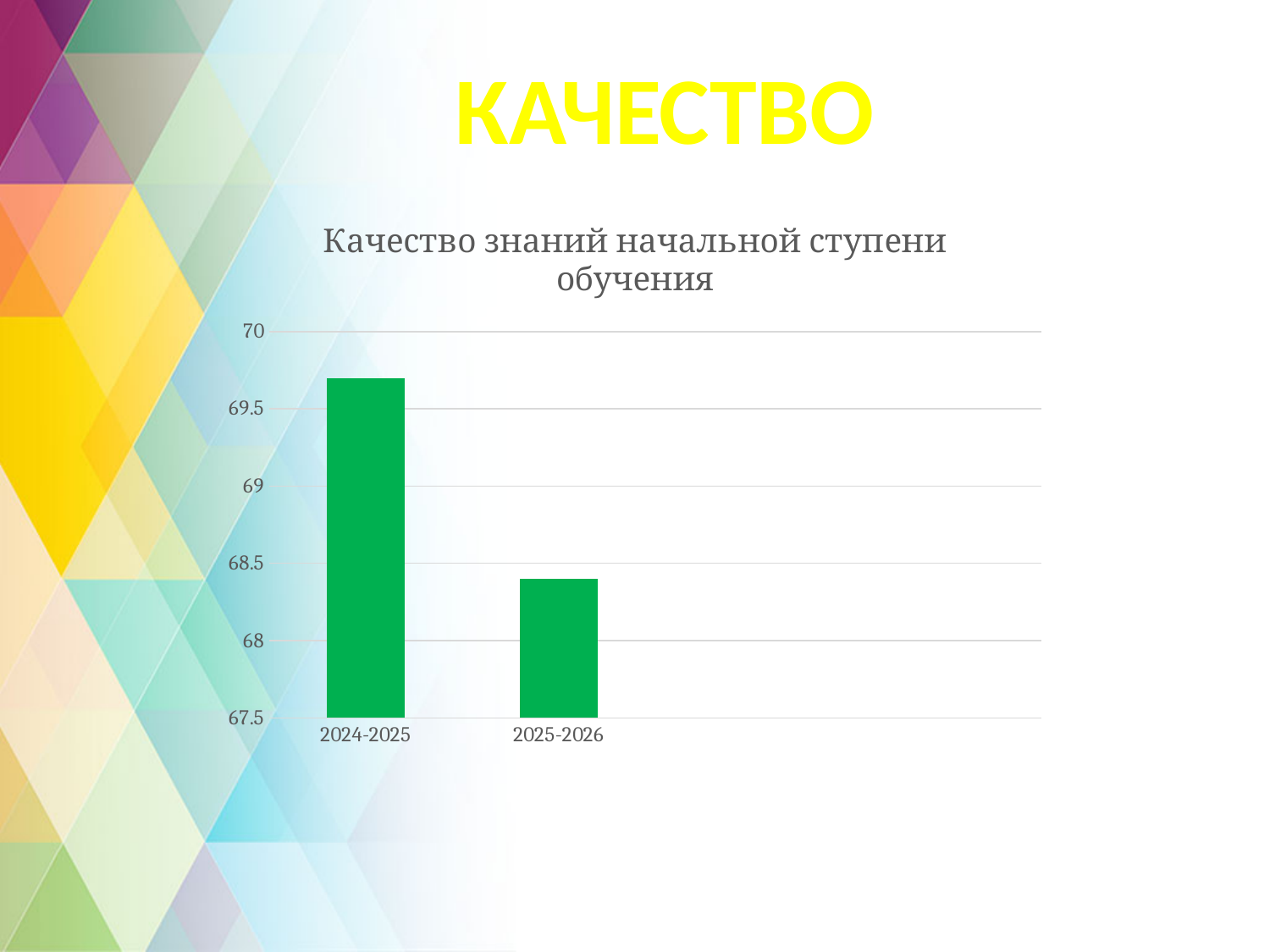
Which category has the lowest value in the chart? 2025-2026 Which is larger, the value for 2024-2025 or the value for 2025-2026? 2024-2025 What kind of chart is shown on the slide? bar chart Is the value for 2024-2025 greater or less than 70? less Do the values rise or fall from 2024-2025 to 2025-2026? fall Is the value for 2025-2026 greater or less than 68.5? less What colour are the bars in the chart? green What is the title of the chart? Качество знаний начальной ступени обучения Which category has the highest value in the chart? 2024-2025 Is the value for 2024-2025 greater or less than 69.5? greater How many categories are shown on the x axis of the chart? 2